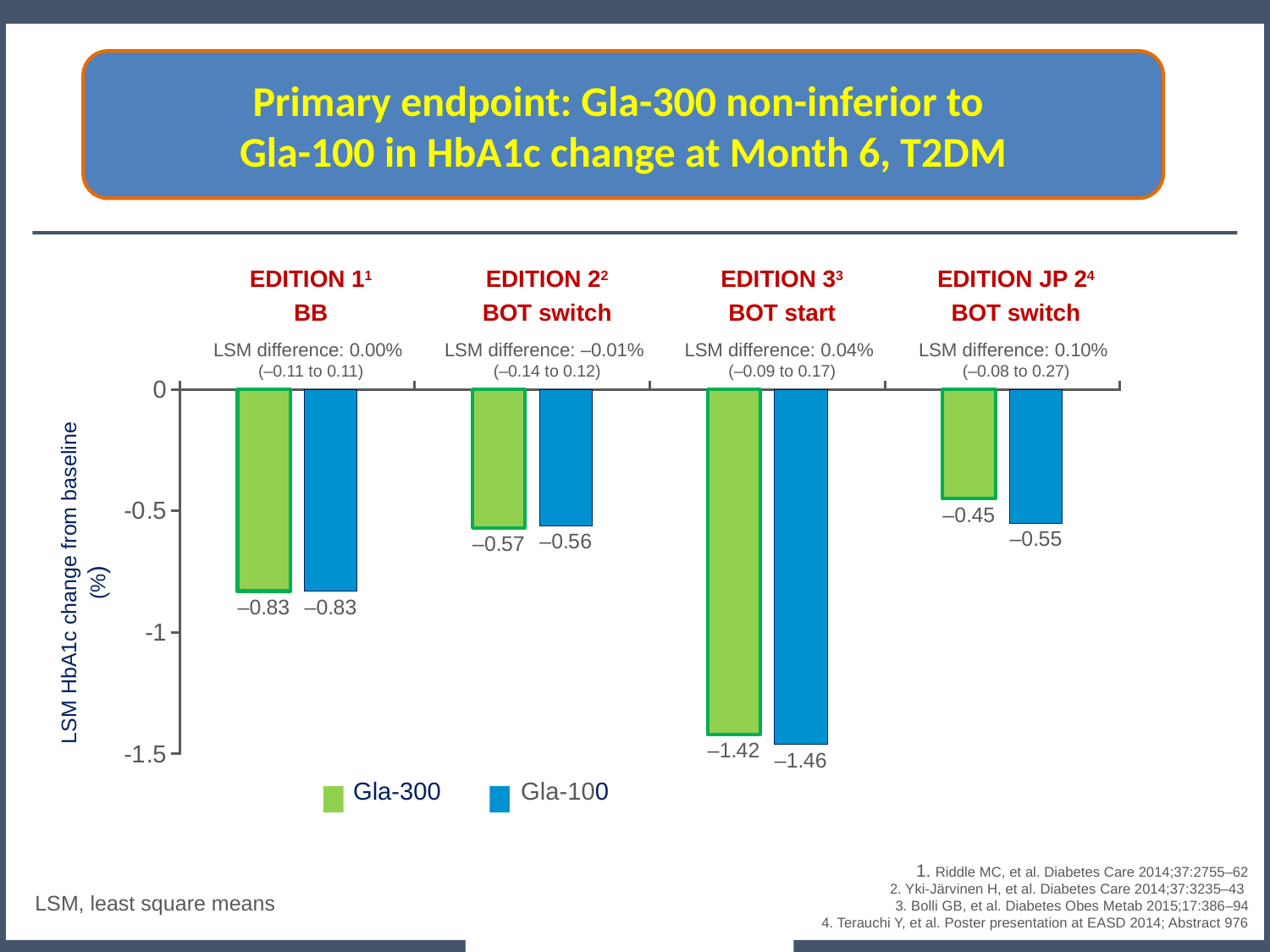
Which study shows the smallest reduction in HbA1c for Gla-100? EDITION JP 2 What is the LSM HbA1c change from baseline for Gla-100 in EDITION 3? –1.46 What kind of chart is shown on the slide? Bar chart What is the LSM HbA1c change from baseline for Gla-100 in EDITION 2? –0.56 What is the LSM HbA1c change from baseline for Gla-300 in EDITION JP 2? –0.45 What is the LSM HbA1c change from baseline for Gla-300 in EDITION 1? –0.83 What is the difference between the Gla-300 and Gla-100 HbA1c changes in EDITION JP 2? 0.10 How many series does the legend list? 2 Which study shows the largest reduction in HbA1c for Gla-300? EDITION 3 In EDITION 3, which treatment shows the larger reduction in HbA1c, Gla-300 or Gla-100? Gla-100 How many studies (category groups) are shown on the chart? 4 What is the LSM difference reported for EDITION 3? 0.04%